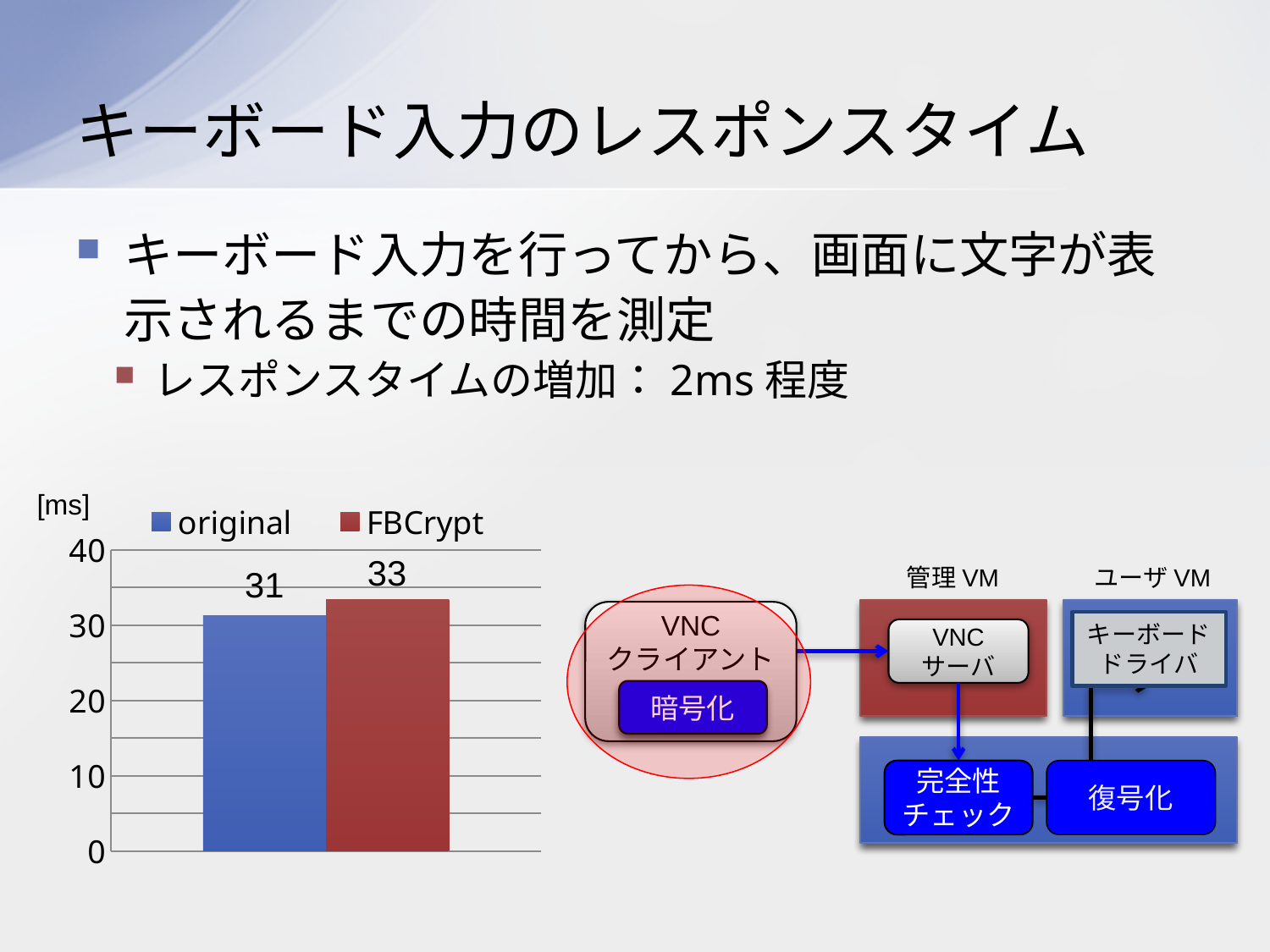
What colour is the FBCrypt bar? red What unit is shown on the chart's vertical axis? ms How many bars are plotted in the chart? 2 Is the value for FBCrypt greater or less than 40? less How many series does the legend list? 2 Is the value for original greater or less than 30? greater Which series has the higher value, original or FBCrypt? FBCrypt What is the difference between the FBCrypt value and the original value? 2 What is the value for original? 31 What kind of chart is shown on the slide? bar chart What is the value for FBCrypt? 33 Which series has the lowest value? original